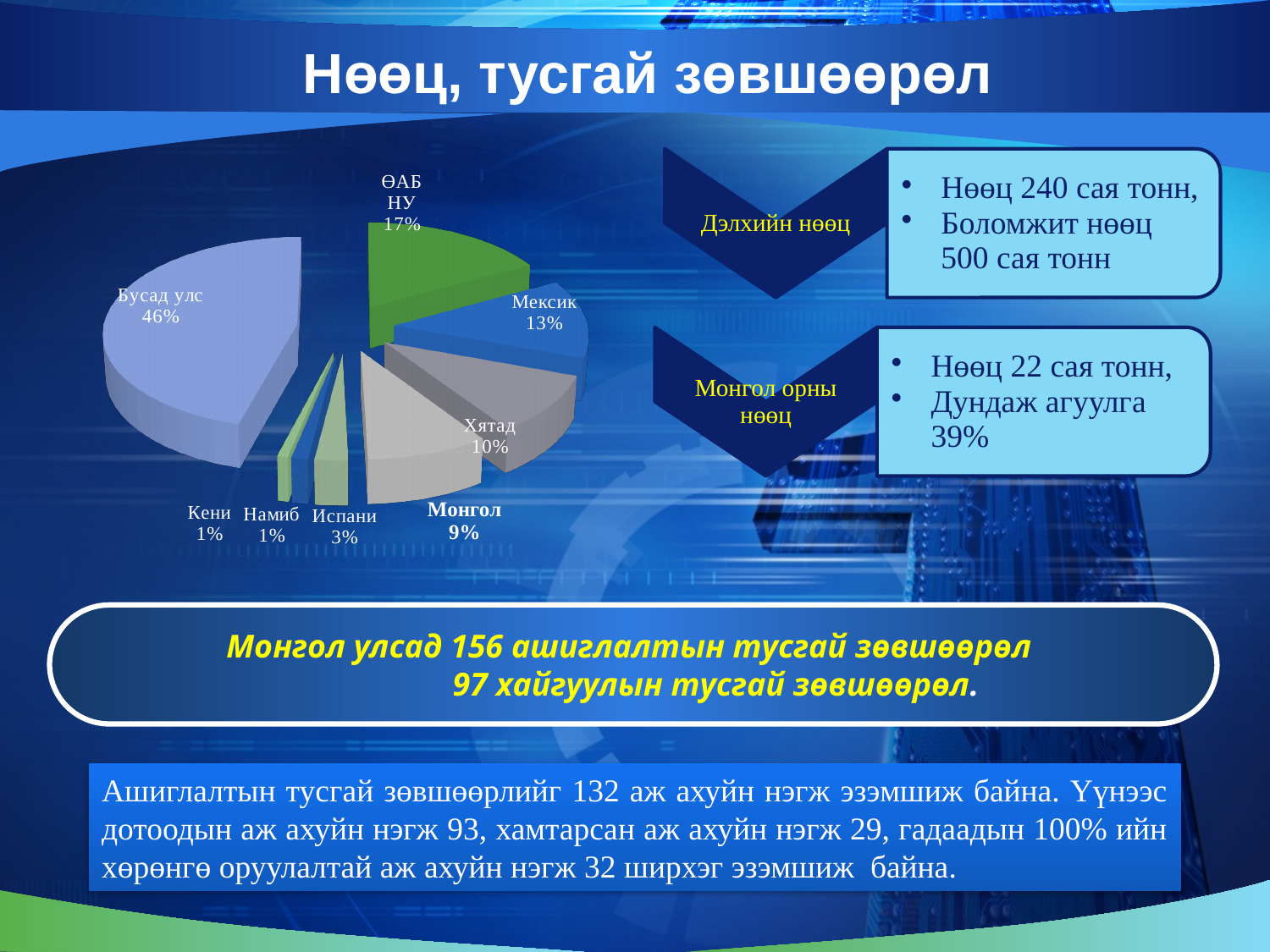
What kind of chart is shown on the slide? pie chart What share of the pie does Бусад улс have? 46% What is the difference between the shares of ӨАБНУ and Хятад? 7% What is the value shown for ӨАБНУ in the pie chart? 17% What is the value shown for Мексик in the pie chart? 13% What is the value shown for Испани in the pie chart? 3% How many slices does the pie chart have? 8 What is the difference between the shares of Бусад улс and Монгол? 37% What is the value shown for Монгол in the pie chart? 9% What is the title of the slide containing the pie chart? Нөөц, тусгай зөвшөөрөл Which is larger in the pie chart, Мексик or Хятад? Мексик Which category has the largest slice in the pie chart? Бусад улс